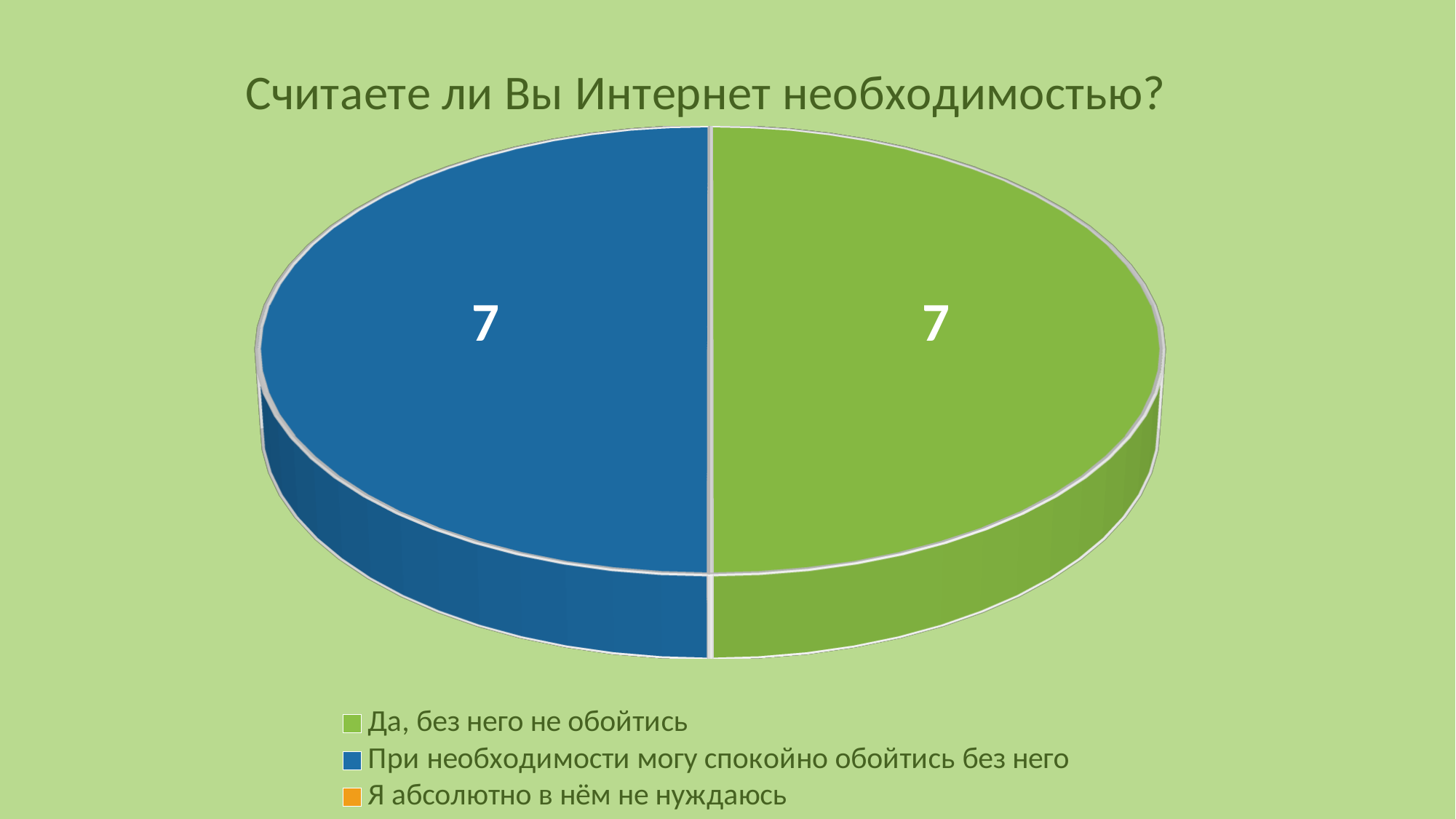
How many entries does the legend list? 3 What is the total of the two labelled slices in the pie? 14 What colour is the slice for "При необходимости могу спокойно обойтись без него"? Blue What is the title of the chart? Считаете ли Вы Интернет необходимостью? What is the value for "Да, без него не обойтись"? 7 What is the value for "При необходимости могу спокойно обойтись без него"? 7 What is the difference between the value for "Да, без него не обойтись" and the value for "При необходимости могу спокойно обойтись без него"? 0 Which is larger, the value for "Да, без него не обойтись" or the value for "При необходимости могу спокойно обойтись без него"? They are equal What kind of chart is shown on the slide? Pie chart What share of the pie does the "Да, без него не обойтись" slice represent? 50% How many slices with data labels are visible in the pie? 2